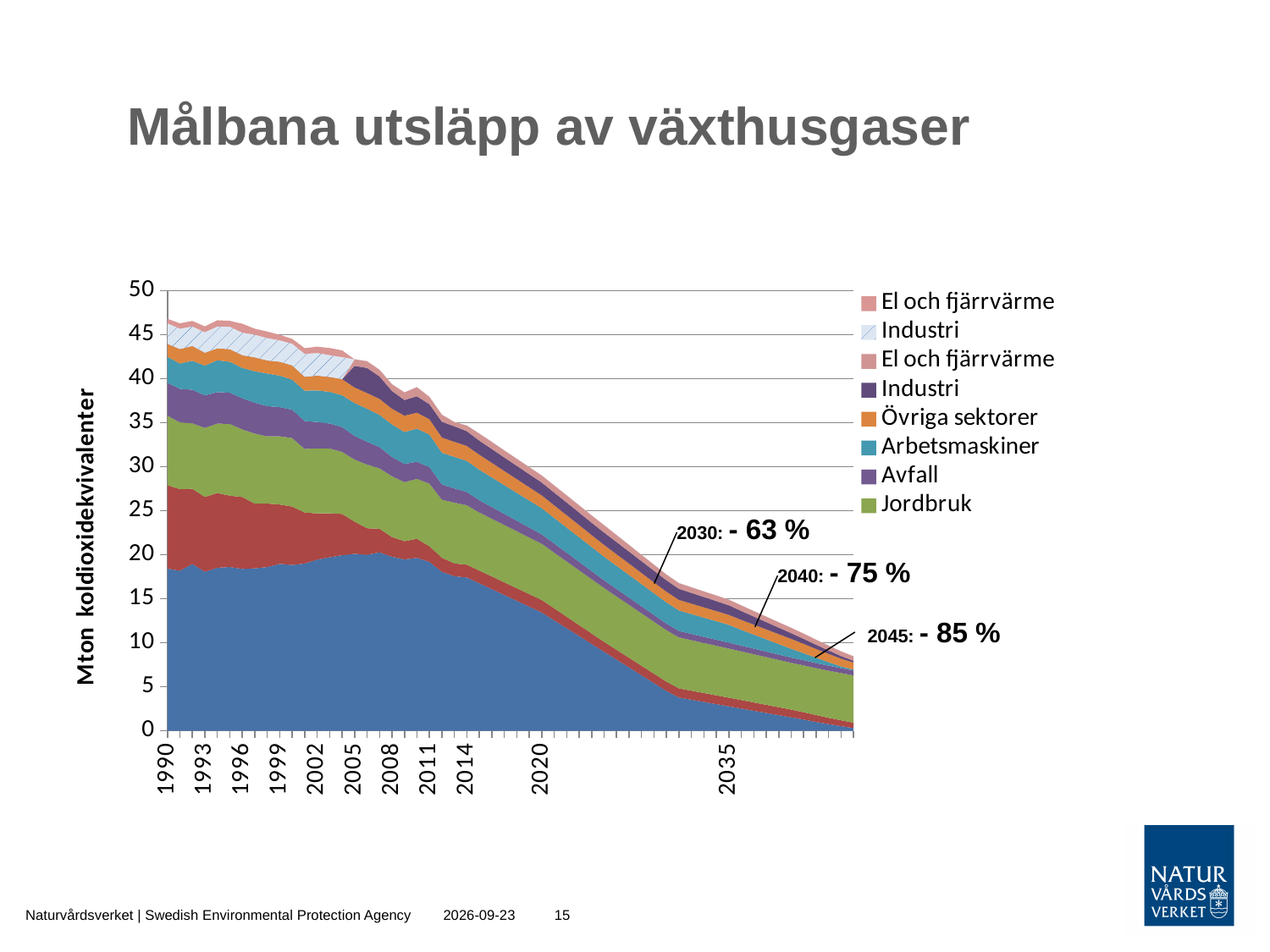
Is the total emissions value in 2045 greater or less than 10? less What percentage reduction is annotated for 2030? - 63 % What percentage reduction is annotated for 2040? - 75 % What kind of chart is shown on the slide? Stacked area chart Is the total emissions value in 1990 greater or less than 40? greater What is the label on the vertical axis of the chart? Mton koldioxidekvivalenter Which year has the higher total emissions, 1990 or 2020? 1990 How many series does the legend list? 8 What is the title of the chart on the slide? Målbana utsläpp av växthusgaser Do total emissions rise or fall along the x axis from 1990 to 2045? Fall What percentage reduction is annotated for 2045? - 85 %